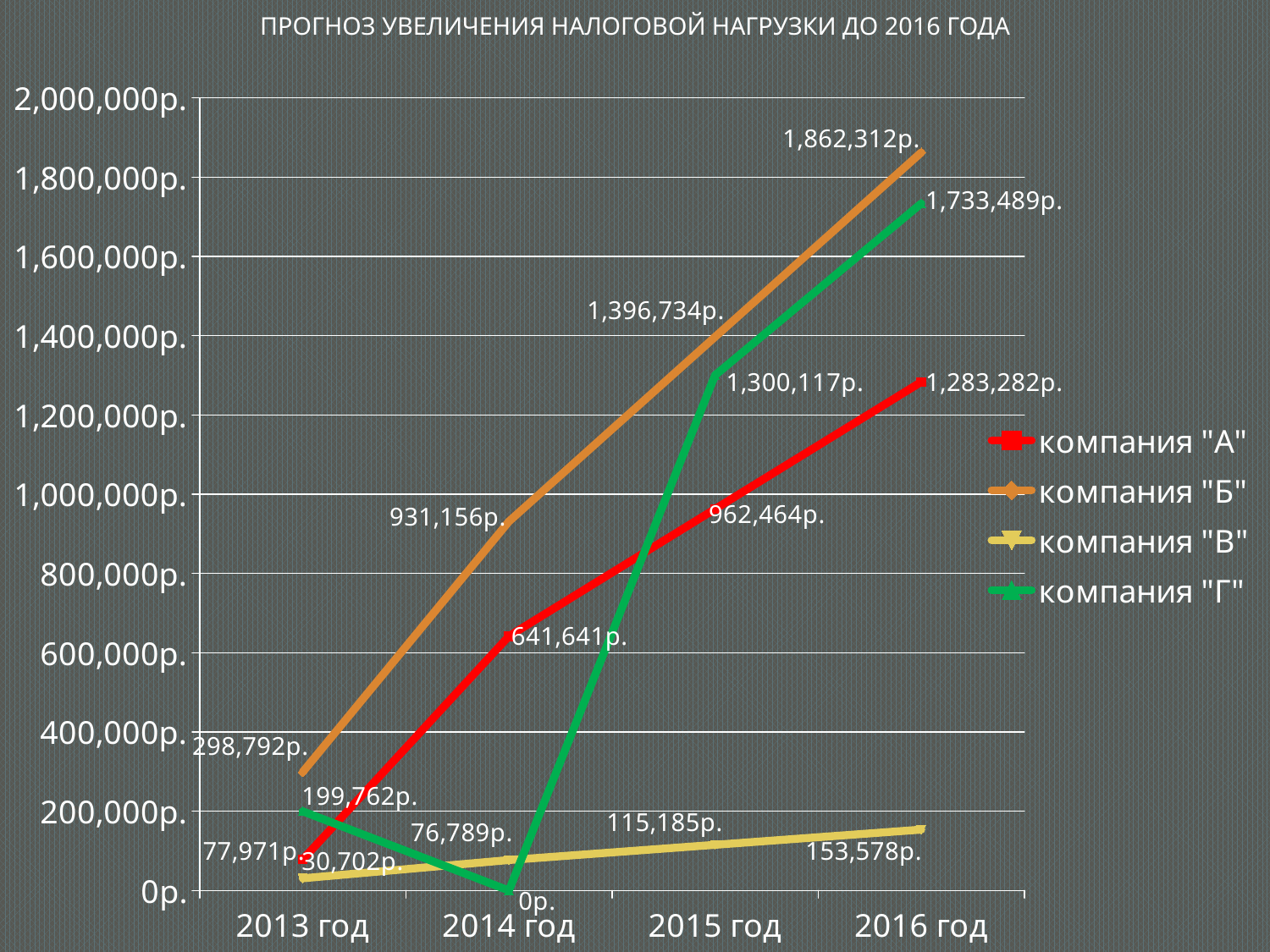
What is the value for компания "Б" in 2016 год? 1,862,312р. What is the value for компания "Г" in 2014 год? 0р. How many series does the legend list? 4 How many years are shown on the x axis? 4 What kind of chart is this? line chart What is the difference between компания "Б" and компания "Г" in 2016 год? 128,823р. Which company has the lowest value in 2013 год? компания "В" What is the value for компания "В" in 2015 год? 115,185р. What is the value for компания "А" in 2014 год? 641,641р. Which company has the highest value in 2016 год? компания "Б" Does the value for компания "Б" rise or fall from 2013 год to 2016 год? rise Which is larger in 2015 год: компания "А" or компания "Г"? компания "Г"